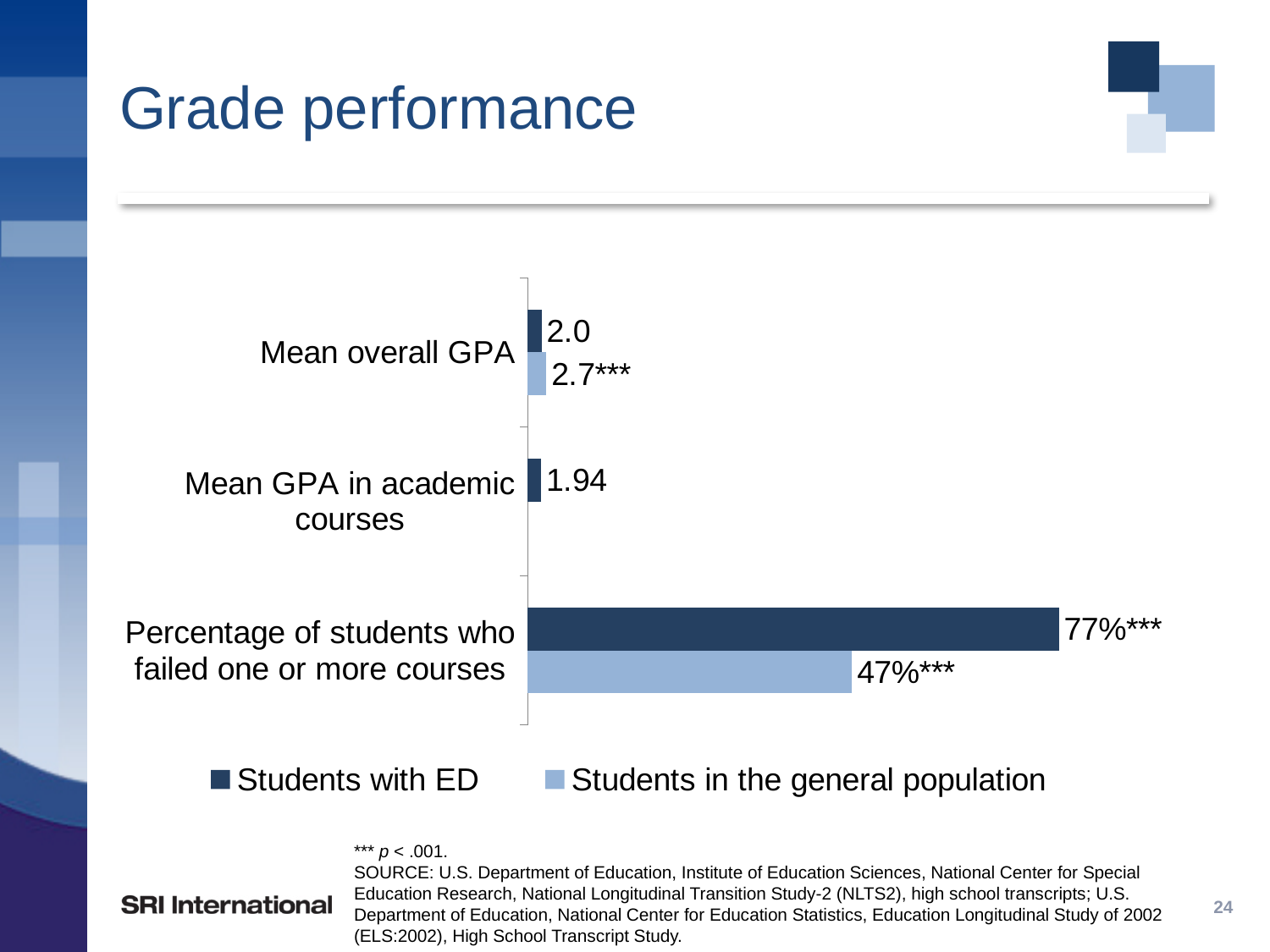
What is the title of the slide containing the chart? Grade performance What is the mean overall GPA for students with ED? 2.0 What is the difference in the percentage of students who failed one or more courses between students with ED and students in the general population? 30 percentage points What percentage of students with ED failed one or more courses? 77%*** Which group has the higher percentage of students who failed one or more courses? Students with ED How many series does the legend list? 2 Which group has the higher mean overall GPA, students with ED or students in the general population? Students in the general population What is the mean overall GPA for students in the general population? 2.7*** What is the mean GPA in academic courses for students with ED? 1.94 What percentage of students in the general population failed one or more courses? 47%*** What kind of chart is shown on the slide? Bar chart How many categories are shown on the chart? 3